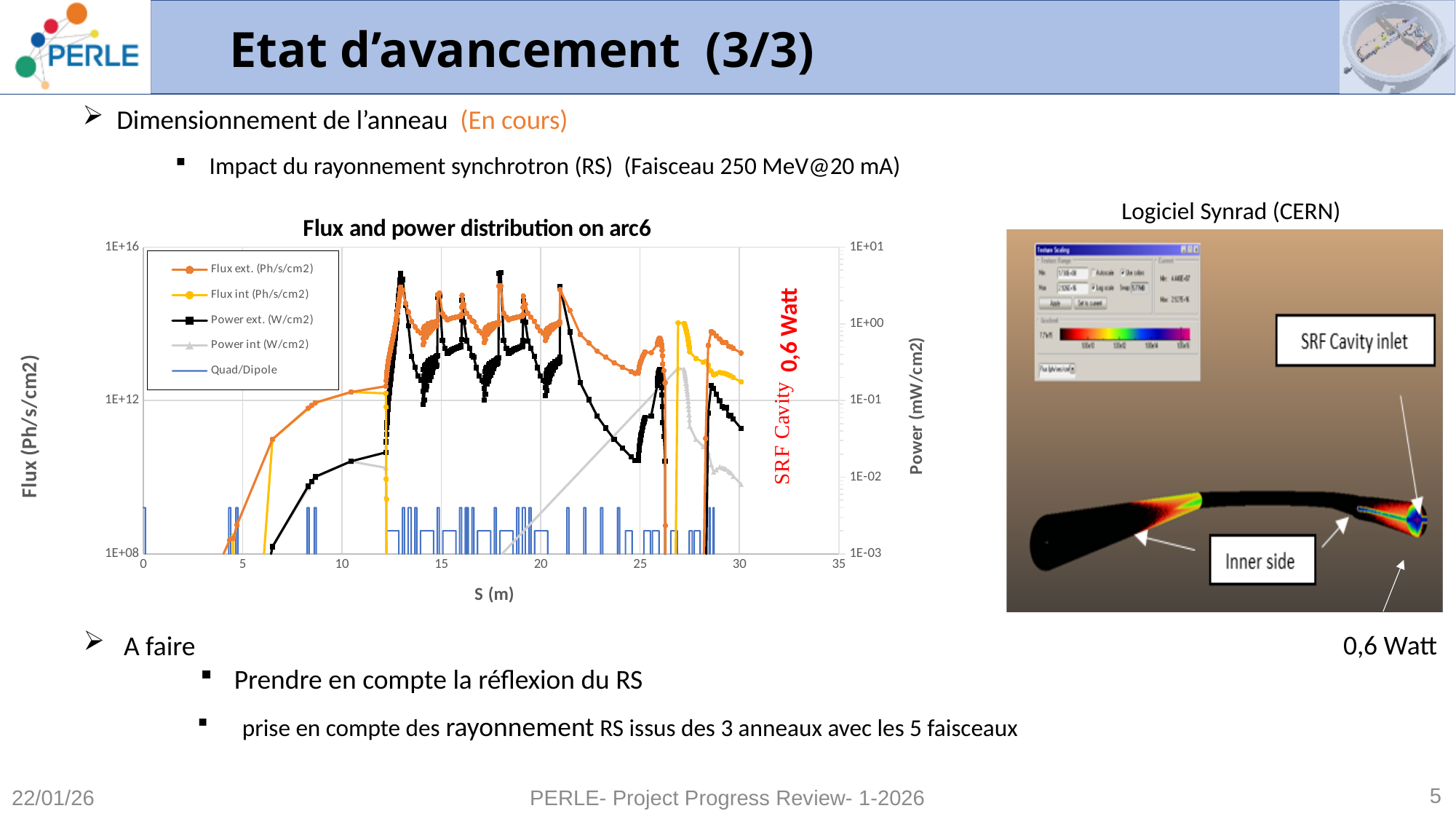
In the 'Flux and power distribution on arc6' chart, is the Flux int (Ph/s/cm2) peak near S = 27 m greater or less than 1E+12? greater In the 'Flux and power distribution on arc6' chart, is the Flux ext. (Ph/s/cm2) value at S = 5 m greater or less than 1E+12? less What is the title of the chart on the slide? Flux and power distribution on arc6 In the 'Flux and power distribution on arc6' chart, is the Power ext. (W/cm2) value at S = 25 m greater or less than 1E-01 on the right-hand axis? less In the 'Flux and power distribution on arc6' chart, which series has a higher value at S = 15 m: Flux ext. (Ph/s/cm2) or Flux int (Ph/s/cm2)? Flux ext. (Ph/s/cm2) In the 'Flux and power distribution on arc6' chart, does the Flux ext. (Ph/s/cm2) series rise or fall between S = 0 m and S = 10 m? rise What type of chart is 'Flux and power distribution on arc6'? line chart What is the label of the x axis of the 'Flux and power distribution on arc6' chart? S (m) How many series does the legend of the 'Flux and power distribution on arc6' chart list? 5